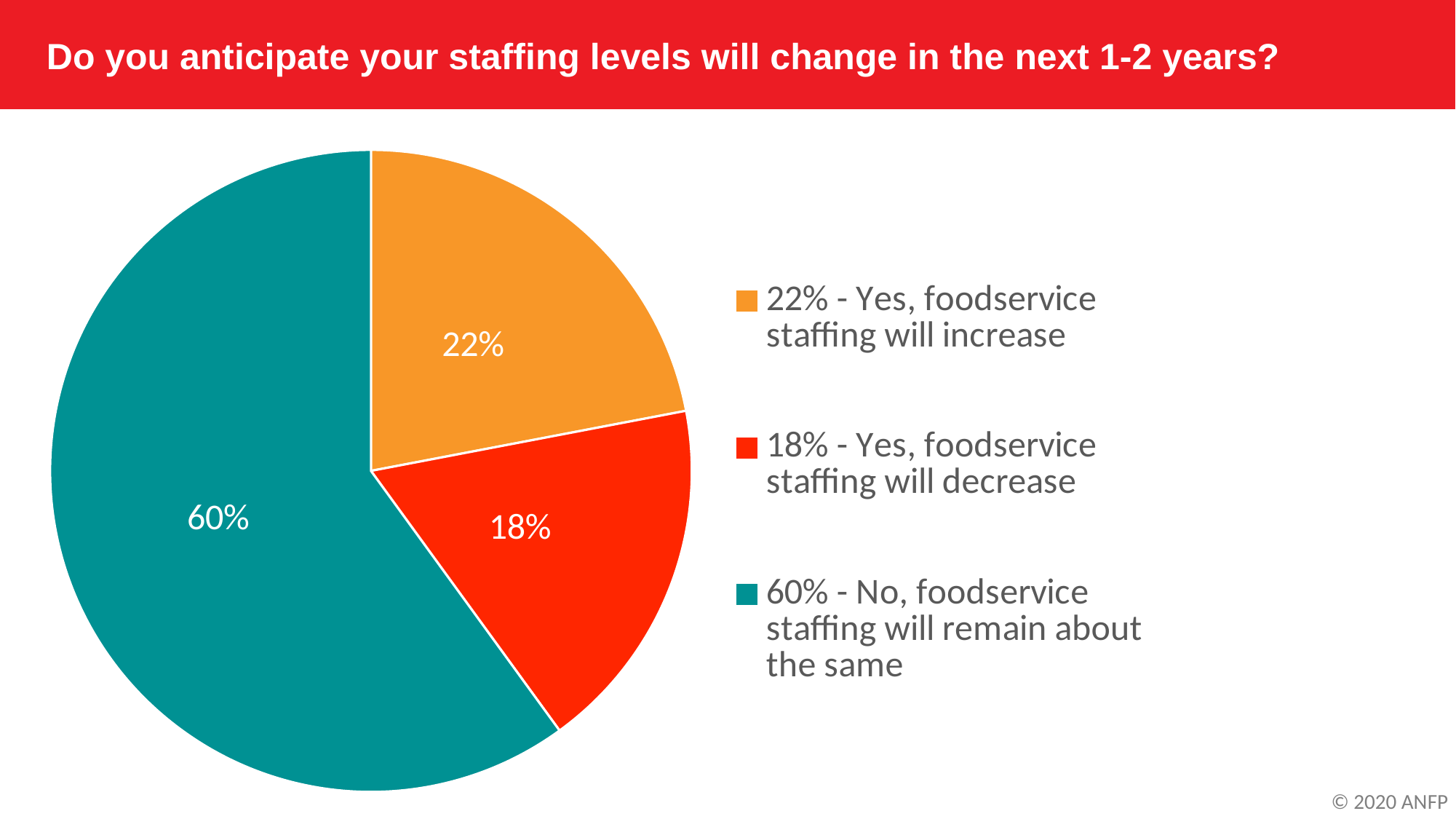
What is the difference in percentage points between the 'remain about the same' slice and the 'will increase' slice? 38 Which is larger: the share saying staffing will increase or the share saying staffing will decrease? staffing will increase What share of respondents said foodservice staffing will decrease? 18% What kind of chart is shown on the slide? pie chart What share of respondents said foodservice staffing will remain about the same? 60% How many slices does the pie chart have? 3 What share of respondents said foodservice staffing will increase? 22% What is the difference in percentage points between the 'will increase' slice and the 'will decrease' slice? 4 What is the title of the slide? Do you anticipate your staffing levels will change in the next 1-2 years? What colour is the slice for 'No, foodservice staffing will remain about the same'? teal Which response has the largest slice of the pie? No, foodservice staffing will remain about the same Which response has the smallest slice of the pie? Yes, foodservice staffing will decrease